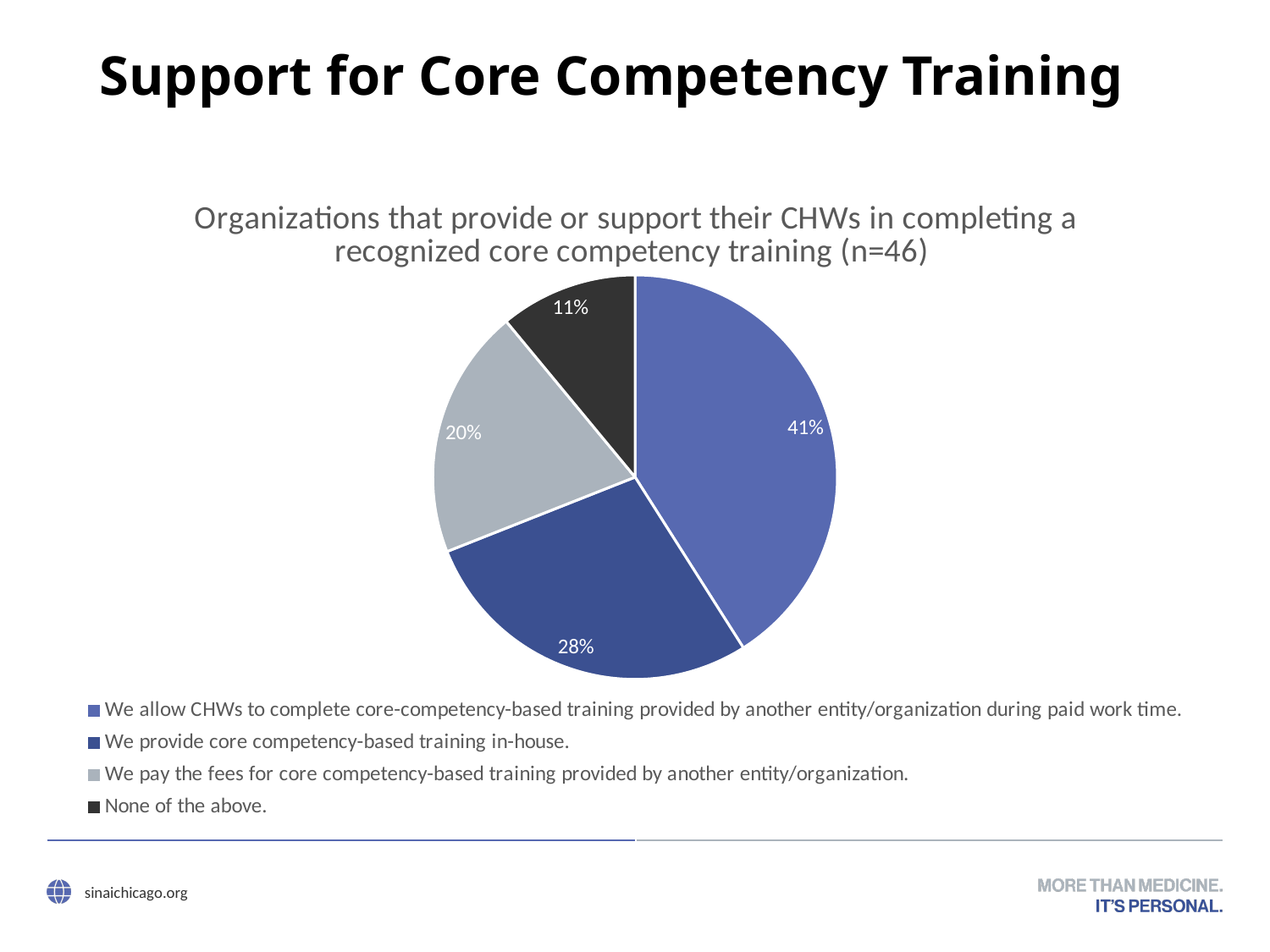
What share of the pie is for "We provide core competency-based training in-house."? 28% What is the sample size (n) stated in the chart title? 46 What share of the pie is for "We pay the fees for core competency-based training provided by another entity/organization."? 20% How many slices does the pie chart have? 4 Which is larger: the slice for "We pay the fees for core competency-based training provided by another entity/organization." or the slice for "None of the above."? We pay the fees for core competency-based training provided by another entity/organization. What kind of chart is shown on the slide? Pie chart What share of the pie is for "None of the above."? 11% Which category has the smallest slice of the pie? None of the above. What is the difference in percentage points between the largest slice (41%) and the "We provide core competency-based training in-house." slice (28%)? 13 percentage points Which category has the largest slice of the pie? We allow CHWs to complete core-competency-based training provided by another entity/organization during paid work time. What colour is the slice for "None of the above."? Black